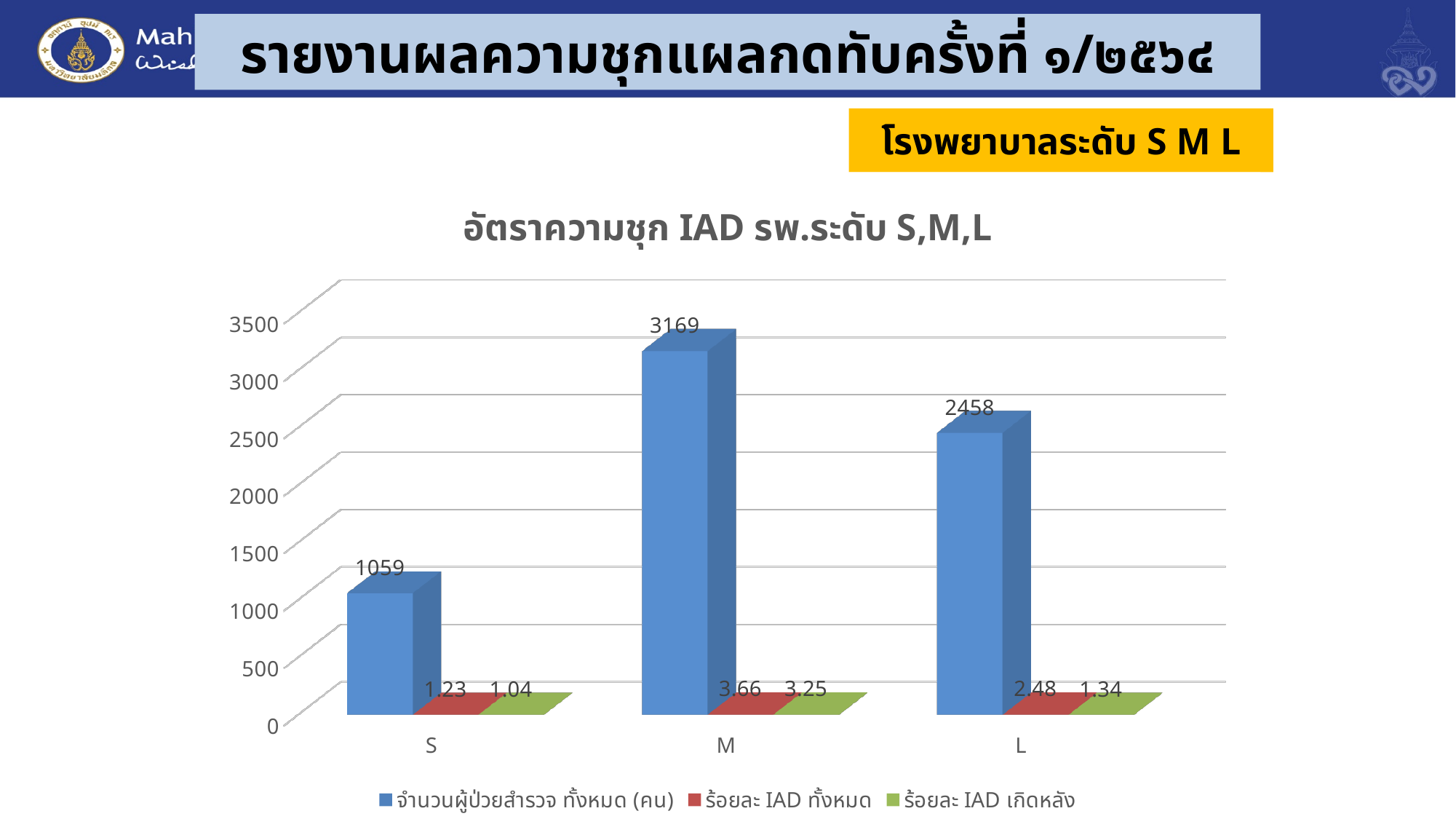
How many series does the legend list? 3 Which category has the highest value for จำนวนผู้ป่วยสำรวจ ทั้งหมด (คน)? M Which is larger: ร้อยละ IAD เกิดหลัง for M or for L? M What is the value of ร้อยละ IAD เกิดหลัง for category S? 1.04 Is the value of จำนวนผู้ป่วยสำรวจ ทั้งหมด (คน) for L greater or less than 2000? greater What is the value of จำนวนผู้ป่วยสำรวจ ทั้งหมด (คน) for category M? 3169 How many categories are shown on the x axis? 3 What is the difference between the จำนวนผู้ป่วยสำรวจ ทั้งหมด (คน) values for M and L? 711 What is the title of the chart? อัตราความชุก IAD รพ.ระดับ S,M,L What type of chart is shown on the slide? bar chart What is the value of ร้อยละ IAD ทั้งหมด for category L? 2.48 Which category has the lowest value for ร้อยละ IAD ทั้งหมด? S